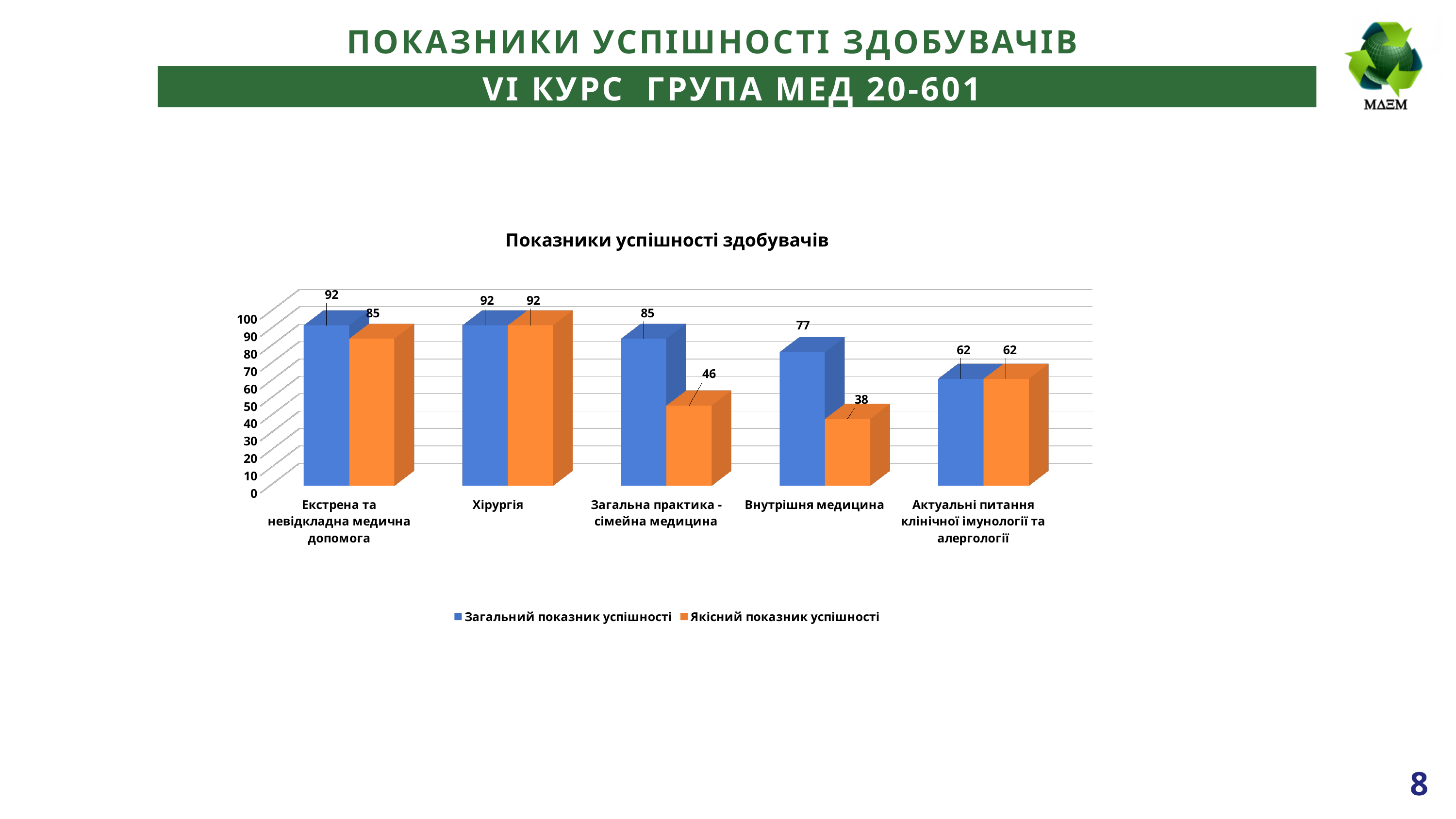
How many categories are shown on the x axis? 5 What is the difference between Загальний показник успішності and Якісний показник успішності for Загальна практика - сімейна медицина? 39 Which category has the lowest Загальний показник успішності? Актуальні питання клінічної імунології та алергології What is the value of Загальний показник успішності for Актуальні питання клінічної імунології та алергології? 62 How many series does the legend list? 2 What is the value of Якісний показник успішності for Внутрішня медицина? 38 Which is larger: Якісний показник успішності for Екстрена та невідкладна медична допомога or for Загальна практика - сімейна медицина? Екстрена та невідкладна медична допомога Which category has the lowest Якісний показник успішності? Внутрішня медицина What kind of chart is shown on the slide? Bar chart What is the value of Якісний показник успішності for Загальна практика - сімейна медицина? 46 What is the value of Загальний показник успішності for Хірургія? 92 What is the difference between Загальний показник успішності and Якісний показник успішності for Внутрішня медицина? 39